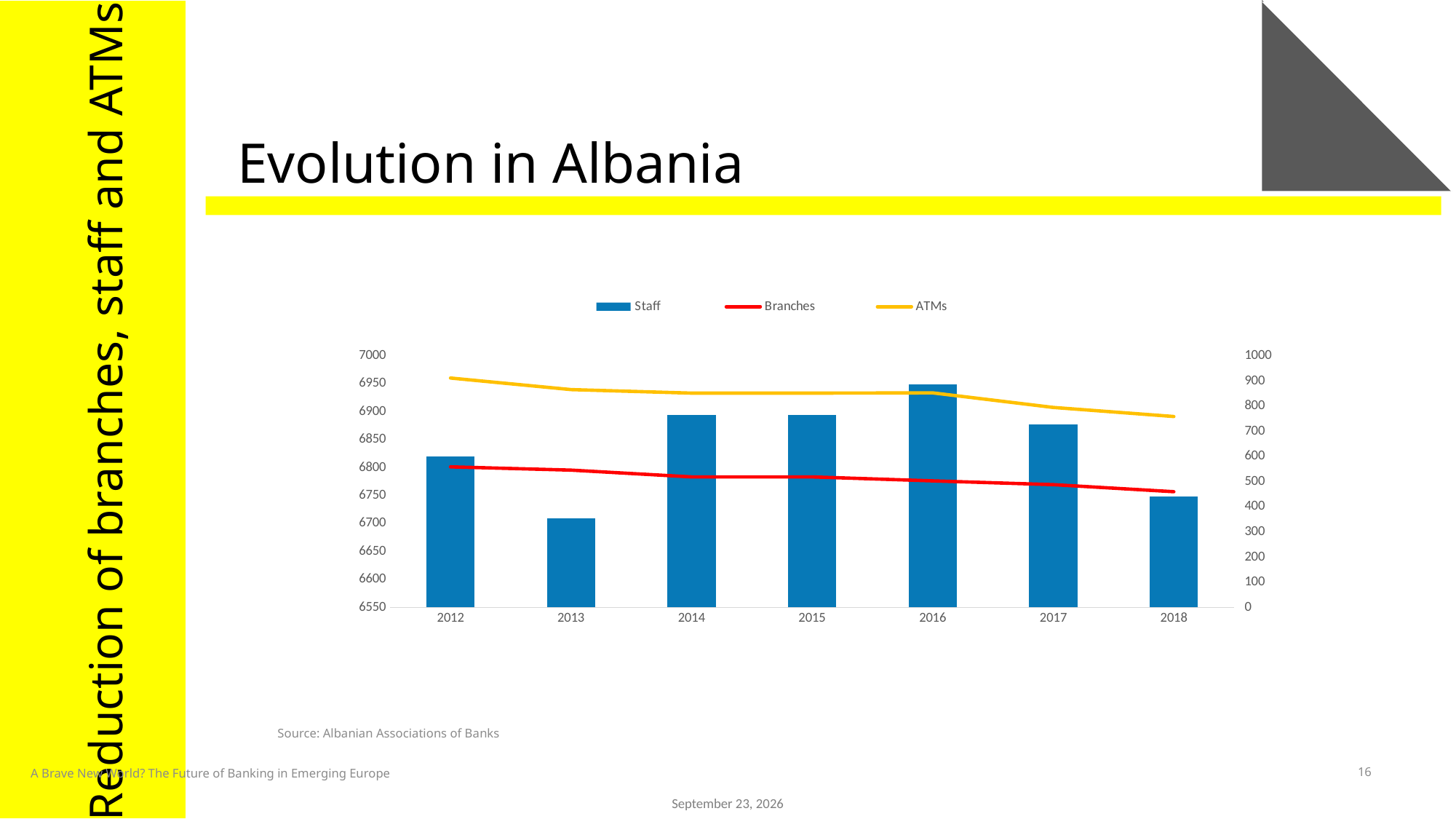
In which year is the Staff bar lowest? 2013 What kind of chart is this? Combination bar and line chart What are the three series shown in the legend? Staff, Branches, ATMs How many years are shown on the x axis? 7 Is the Branches value for 2018 greater or less than 500? less Does the ATMs line rise or fall from 2012 to 2018? Fall Is the Staff value for 2018 greater or less than 6800? less In which year is the Staff bar highest? 2016 Is the Staff value for 2013 greater or less than 6750? less How many series does the legend list? 3 Which year has the larger Staff bar, 2017 or 2018? 2017